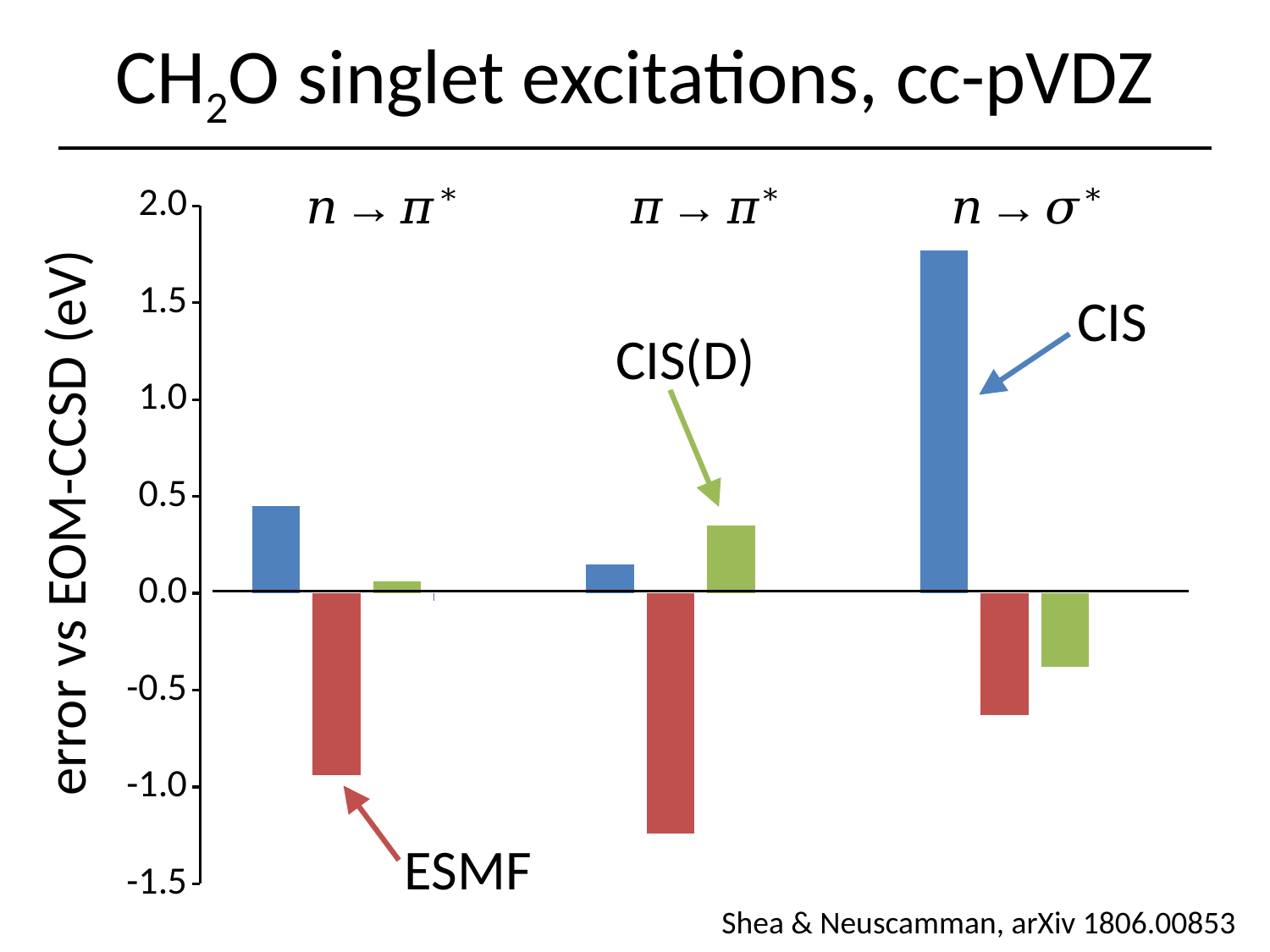
Is the ESMF error for the n → π* excitation greater or less than -0.5 eV? less Is the ESMF error for the π → π* excitation greater or less than -1.0 eV? less How many excitation categories are shown along the x axis? 3 Is the CIS error for the n → σ* excitation greater or less than 1.5 eV? greater What is the label of the y axis? error vs EOM-CCSD (eV) For the π → π* excitation, which has the larger positive error, CIS or CIS(D)? CIS(D) How many methods (series) are plotted in the chart? 3 What kind of chart is shown on the slide? bar chart For which excitation is the ESMF error the most negative? π → π* What is the title of the chart? CH2O singlet excitations, cc-pVDZ For which excitation is the CIS error the largest? n → σ*